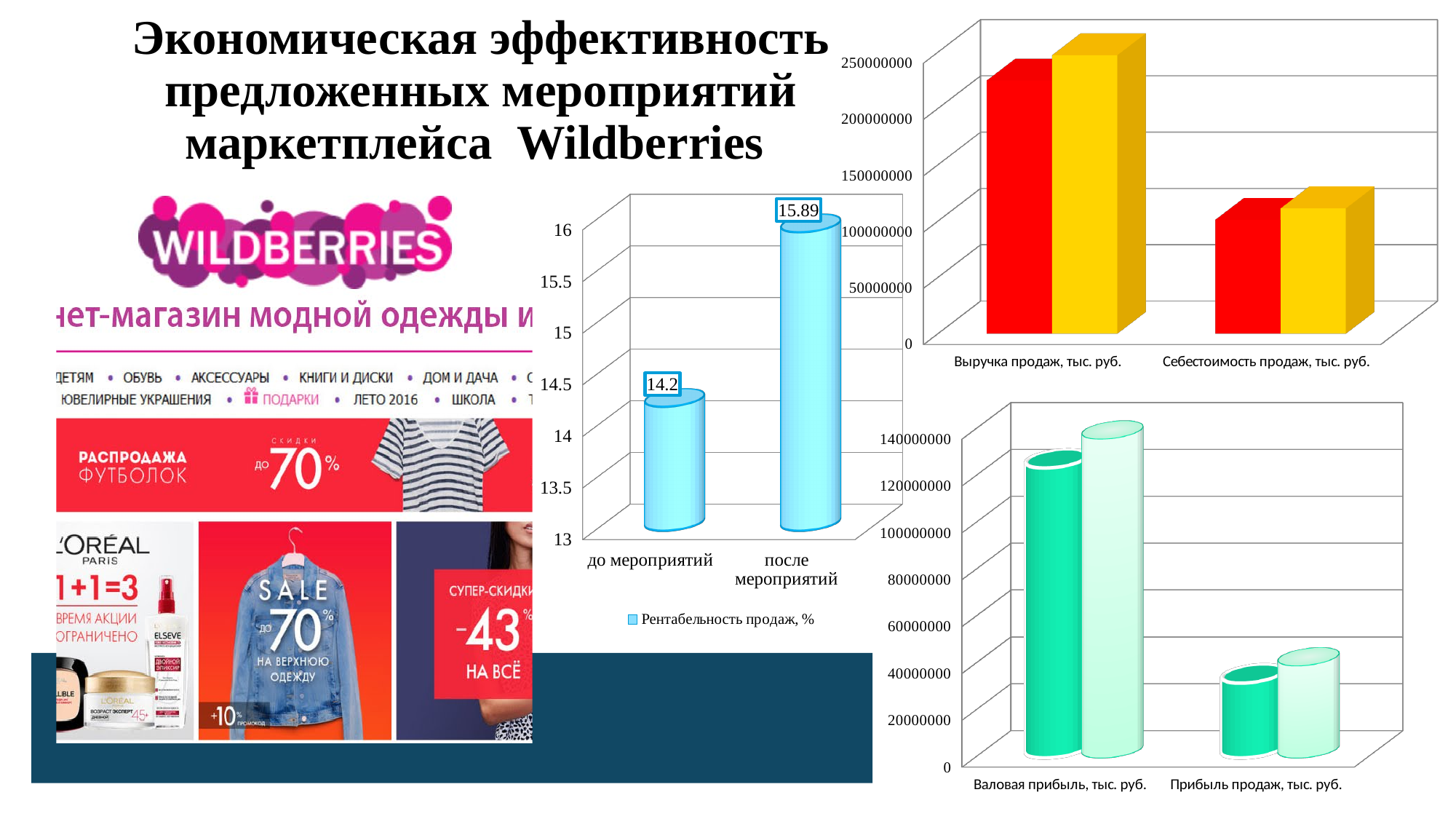
In the middle chart (Рентабельность продаж, %), what is the value for 'после мероприятий'? 15.89 In the middle chart (Рентабельность продаж, %), what series name does the legend show? Рентабельность продаж, % In the middle chart (Рентабельность продаж, %), which category has the higher value? после мероприятий In the middle chart (Рентабельность продаж, %), do the values rise or fall from 'до мероприятий' to 'после мероприятий'? rise What kind of chart is the top-right chart with the red and yellow bars? bar chart In the top-right chart, which category has larger values: 'Выручка продаж, тыс. руб.' or 'Себестоимость продаж, тыс. руб.'? Выручка продаж, тыс. руб. In the middle chart (Рентабельность продаж, %), what is the difference between the value after the measures and the value before the measures? 1.69 In the bottom-right chart, is the value of the dark green bar for 'Прибыль продаж, тыс. руб.' greater or less than 60000000? less In the top-right chart, is the value of the red bar for 'Выручка продаж, тыс. руб.' greater or less than 200000000? greater In the middle chart (Рентабельность продаж, %), how many categories are plotted? 2 In the middle chart (Рентабельность продаж, %), what is the value for 'до мероприятий'? 14.2 In the bottom-right chart, which category has larger values: 'Валовая прибыль, тыс. руб.' or 'Прибыль продаж, тыс. руб.'? Валовая прибыль, тыс. руб.